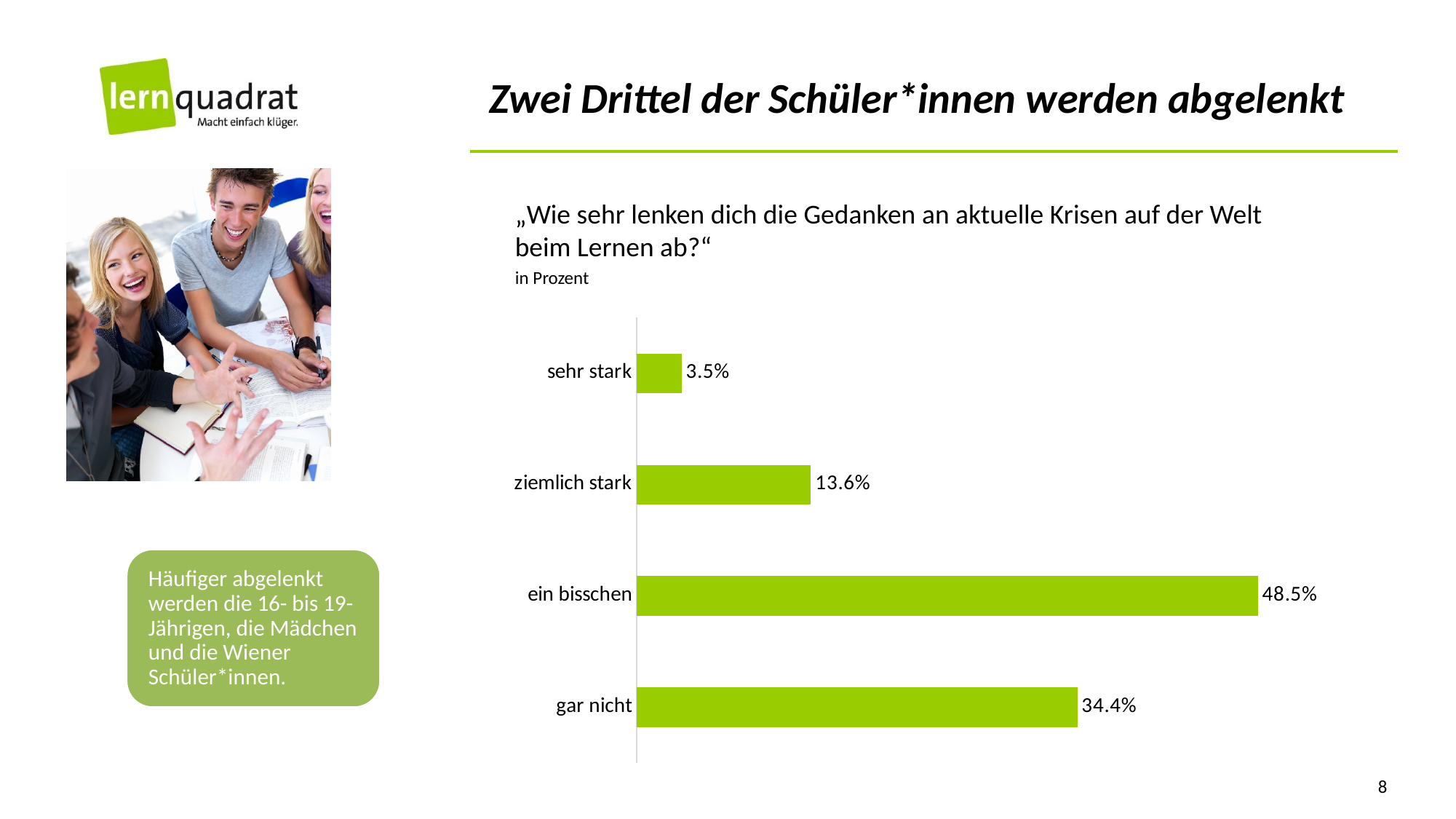
What is the difference between the values for "ziemlich stark" and "sehr stark"? 10.1% What is the value for "ein bisschen"? 48.5% What unit are the chart values given in, according to the text above the chart? in Prozent Which category has the lowest value? sehr stark What is the value for "sehr stark"? 3.5% What is the difference between the values for "ein bisschen" and "gar nicht"? 14.1% Which category has the highest value? ein bisschen What kind of chart is shown on the slide? bar chart What is the value for "gar nicht"? 34.4% How many categories are shown in the chart? 4 What is the value for "ziemlich stark"? 13.6% Which is larger, the value for "gar nicht" or the value for "ziemlich stark"? gar nicht